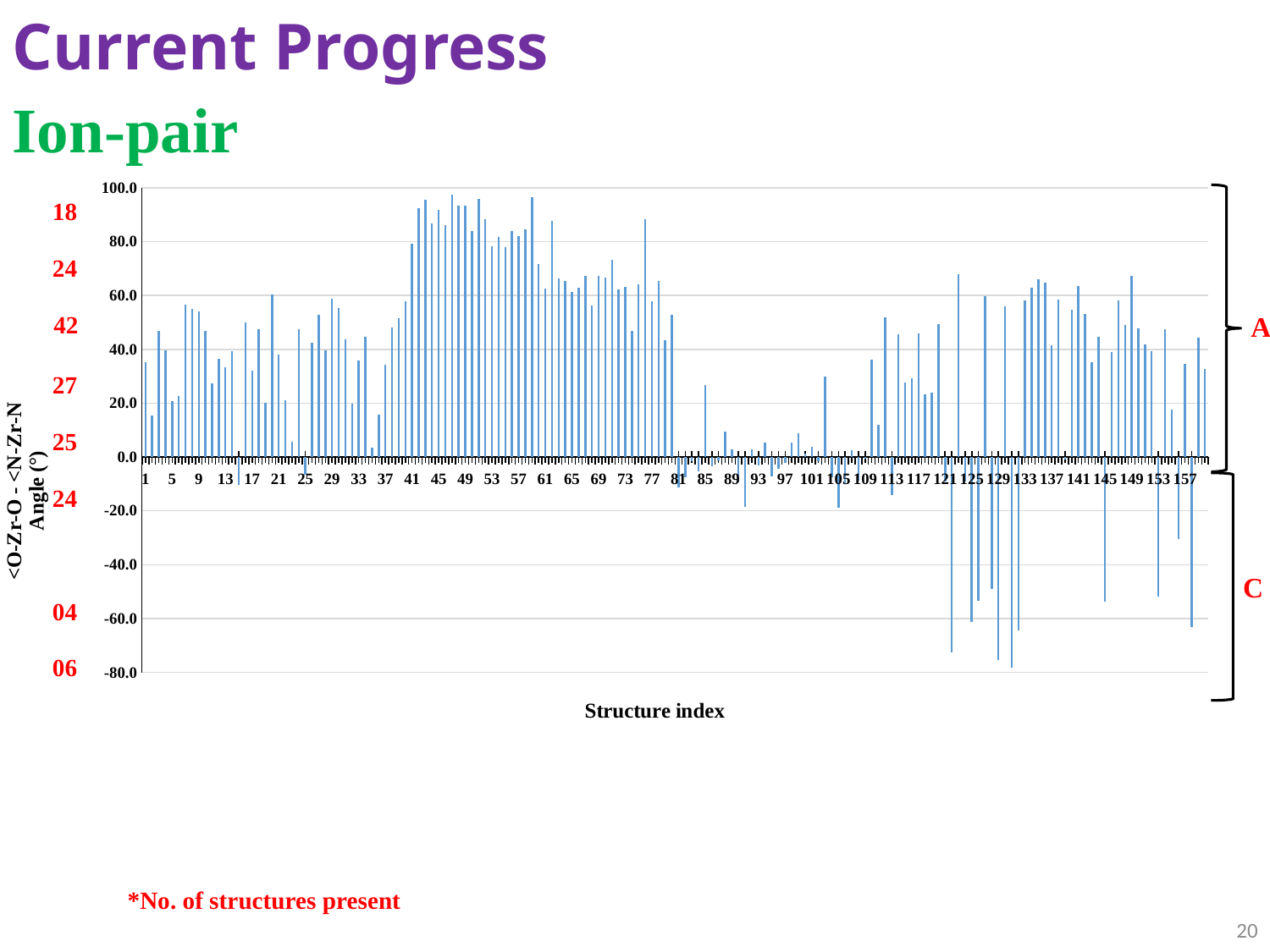
Which has the larger value, structure index 1 or structure index 49? structure index 49 Is the value for structure index 125 greater or less than -20.0? less Is the value for structure index 49 greater or less than 80.0? greater What is the title of the y axis of the chart? <O-Zr-O - <N-Zr-N Angle (°) Is the value for structure index 129 greater or less than -40.0? less What is the title of the x axis of the chart? Structure index Which has the larger value, structure index 41 or structure index 9? structure index 41 What kind of chart is shown on the slide? bar chart Which has the larger value, structure index 129 or structure index 133? structure index 133